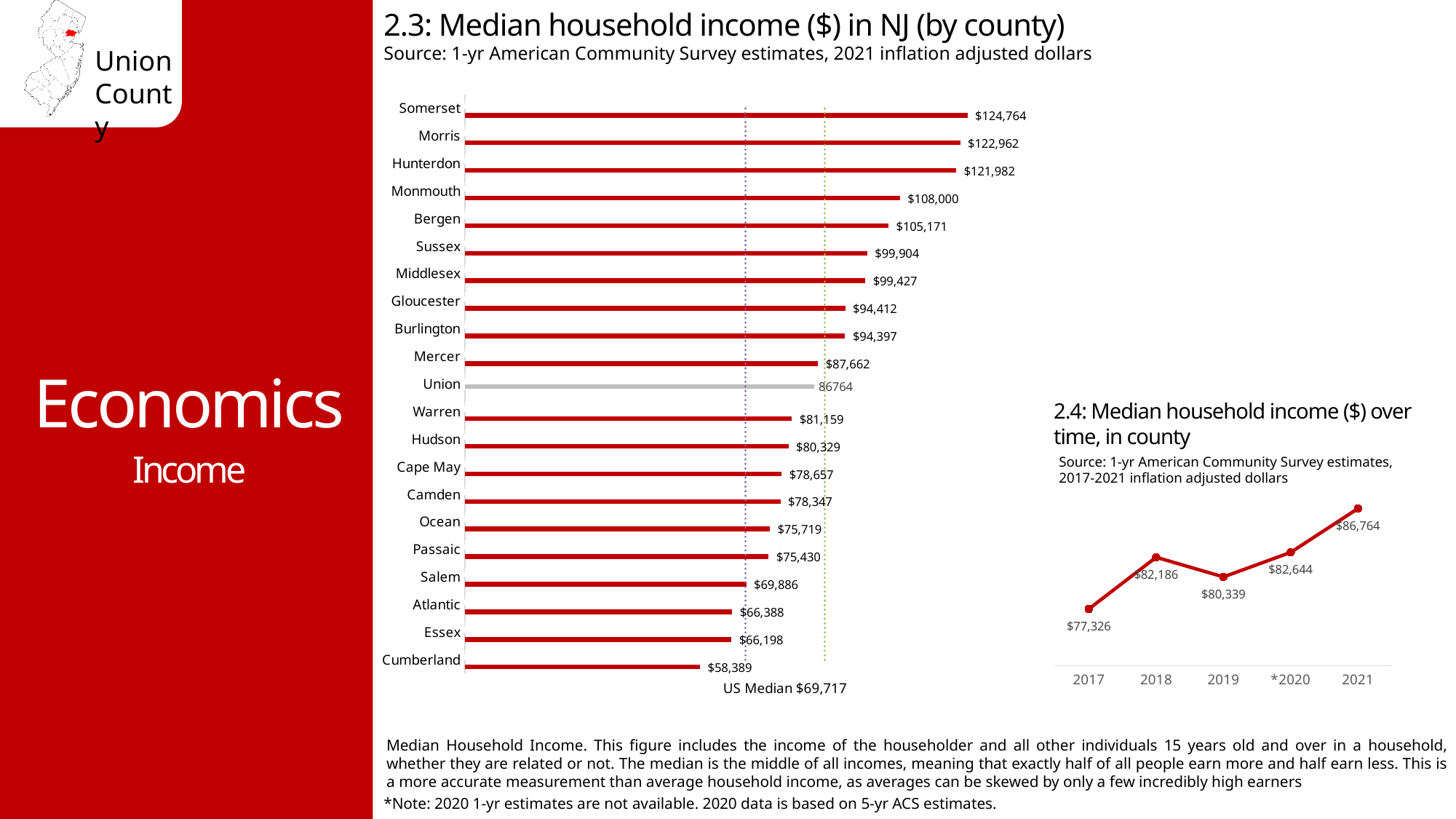
In chart 2.3 (Median household income in NJ by county), how many counties are plotted? 21 What kind of chart is chart 2.3 (Median household income in NJ by county)? Bar chart In chart 2.3 (Median household income in NJ by county), what is the median household income for Somerset? $124,764 In chart 2.3 (Median household income in NJ by county), what is the difference between Monmouth's and Bergen's median household income? $2,829 What kind of chart is chart 2.4 (Median household income over time, in county)? Line chart In chart 2.3 (Median household income in NJ by county), which county has the lowest median household income? Cumberland In chart 2.4 (Median household income over time, in county), what is the median household income for 2019? $80,339 In chart 2.3 (Median household income in NJ by county), what US Median value is noted below the chart? $69,717 In chart 2.3 (Median household income in NJ by county), which has a higher median household income, Hudson or Warren? Warren In chart 2.3 (Median household income in NJ by county), what is the median household income for Union? 86764 In chart 2.4 (Median household income over time, in county), what is the difference between the 2021 and 2017 values? $9,438 In chart 2.3 (Median household income in NJ by county), which county has the highest median household income? Somerset